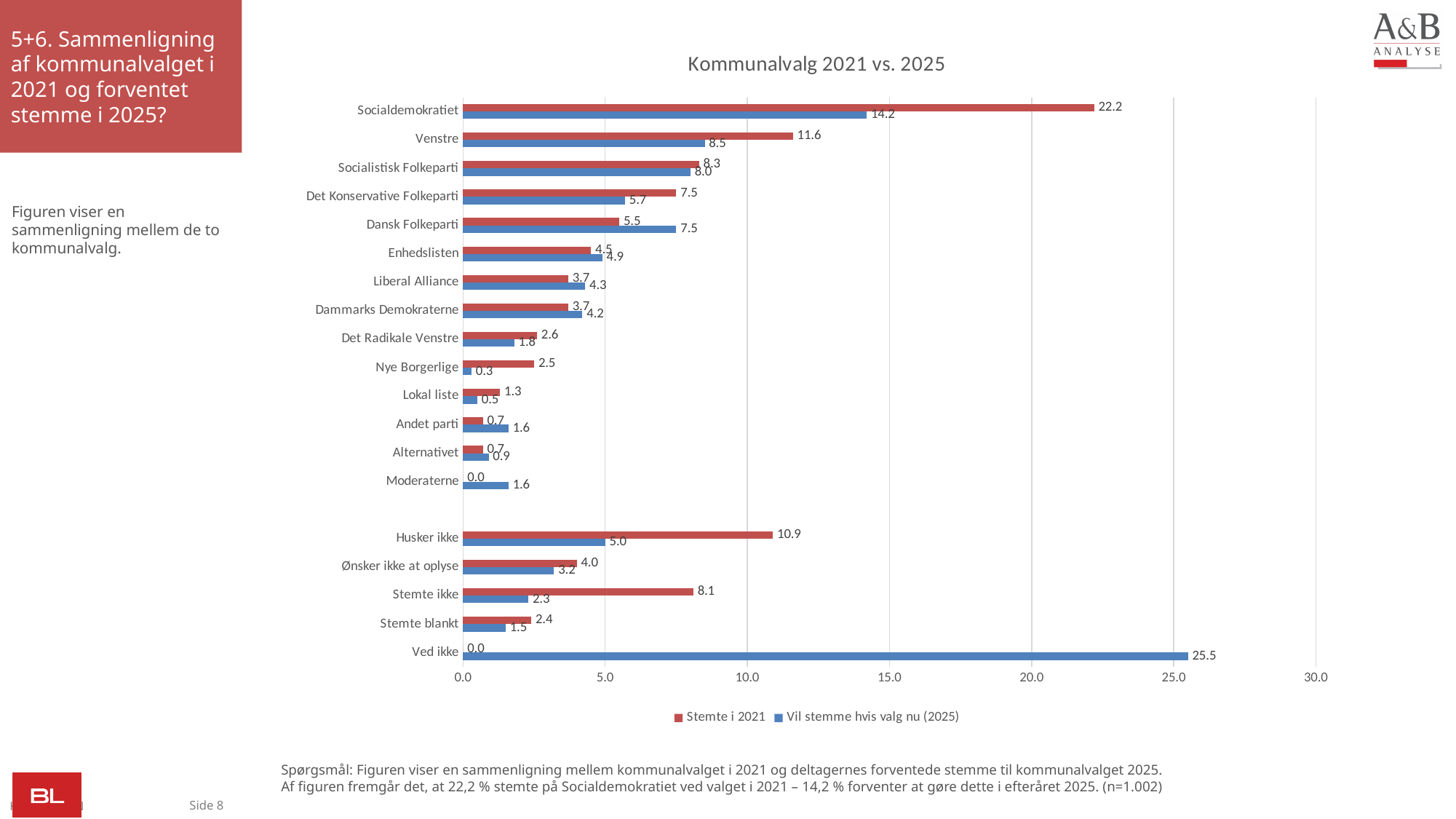
How many categories are shown on the chart? 19 What is the value for Husker ikke in the 'Stemte i 2021' series? 10.9 What is the value for Dansk Folkeparti in the 'Vil stemme hvis valg nu (2025)' series? 7.5 For Moderaterne, which series has the larger value: 'Stemte i 2021' or 'Vil stemme hvis valg nu (2025)'? Vil stemme hvis valg nu (2025) Which category has the highest value in the 'Stemte i 2021' series? Socialdemokratiet Which category has the highest value in the 'Vil stemme hvis valg nu (2025)' series? Ved ikke What is the difference between the 'Stemte i 2021' and 'Vil stemme hvis valg nu (2025)' values for Stemte ikke? 5.8 What type of chart is shown on the slide? Bar chart For Venstre, which series has the larger value: 'Stemte i 2021' or 'Vil stemme hvis valg nu (2025)'? Stemte i 2021 What is the difference between the 'Stemte i 2021' and 'Vil stemme hvis valg nu (2025)' values for Socialdemokratiet? 8.0 How many series does the legend list? 2 What is the value for Socialdemokratiet in the 'Stemte i 2021' series? 22.2